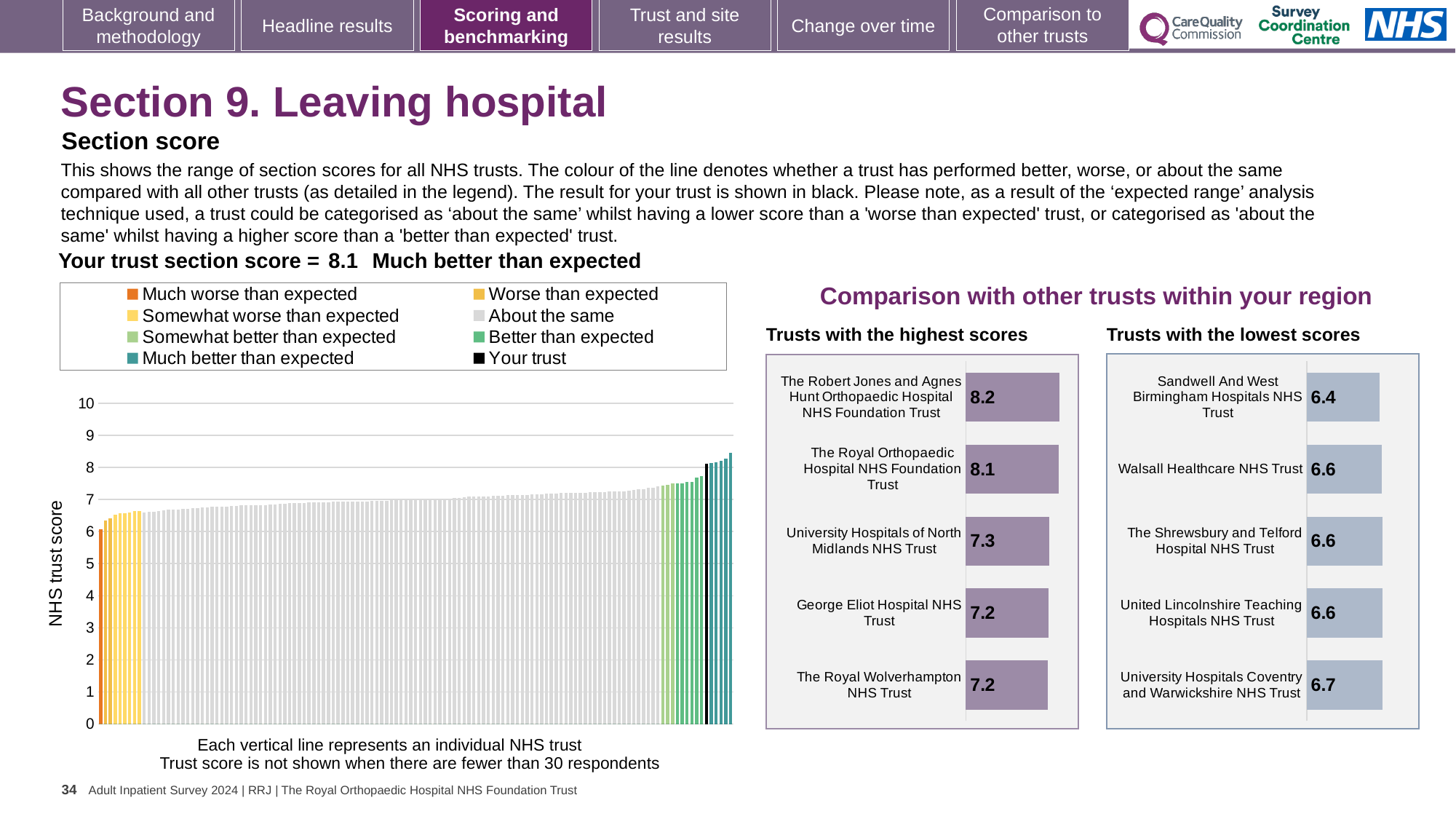
In the 'Trusts with the highest scores' chart, what is the difference between the scores of The Robert Jones and Agnes Hunt Orthopaedic Hospital NHS Foundation Trust and University Hospitals of North Midlands NHS Trust? 0.9 How many trusts are shown in the 'Trusts with the highest scores' chart? 5 What kind of chart is the large 'NHS trust score' chart on the left of the slide? Bar chart In the large 'NHS trust score' chart, what is the section score for your trust (the black bar)? 8.1 In the large 'NHS trust score' chart, is the value of the leftmost (lowest) bar greater or less than 7? less In the 'Trusts with the highest scores' chart, which has the larger score: The Royal Orthopaedic Hospital NHS Foundation Trust or University Hospitals of North Midlands NHS Trust? The Royal Orthopaedic Hospital NHS Foundation Trust How many entries does the legend above the large 'NHS trust score' chart list? 8 In the 'Trusts with the lowest scores' chart, what is the difference between the scores of University Hospitals Coventry and Warwickshire NHS Trust and Sandwell And West Birmingham Hospitals NHS Trust? 0.3 In the 'Trusts with the lowest scores' chart, what is the score for Sandwell And West Birmingham Hospitals NHS Trust? 6.4 In the 'Trusts with the lowest scores' chart, which trust has the lowest score? Sandwell And West Birmingham Hospitals NHS Trust In the 'Trusts with the highest scores' chart, what is the score for The Robert Jones and Agnes Hunt Orthopaedic Hospital NHS Foundation Trust? 8.2 In the 'Trusts with the highest scores' chart, which trust has the highest score? The Robert Jones and Agnes Hunt Orthopaedic Hospital NHS Foundation Trust